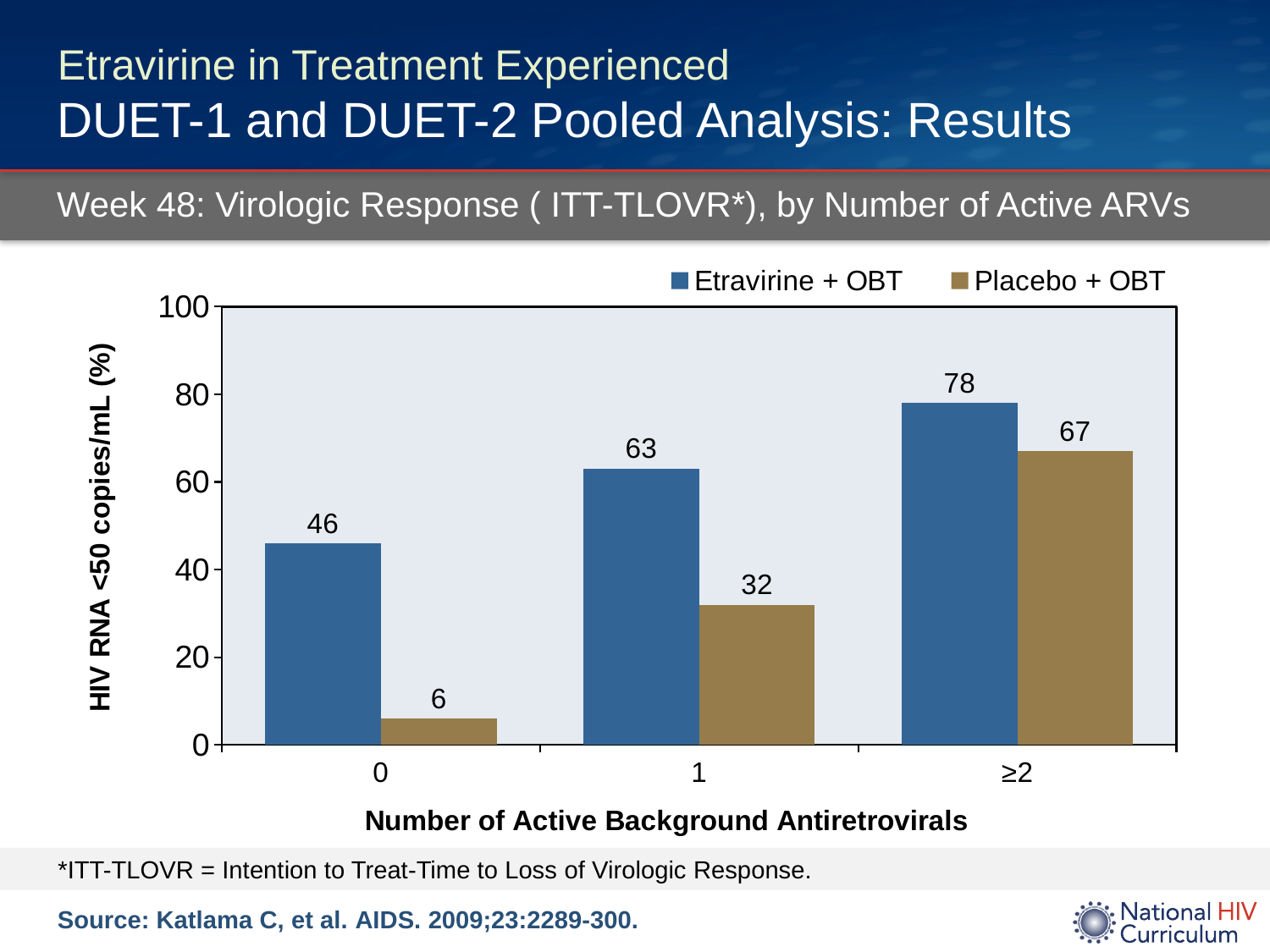
What is the difference between Etravirine + OBT and Placebo + OBT in the 0 active background antiretrovirals group? 40 What is the value for Placebo + OBT in the ≥2 active background antiretrovirals group? 67 What is the difference between Etravirine + OBT and Placebo + OBT in the 1 active background antiretroviral group? 31 What kind of chart is shown on the slide? Bar chart What is the value for Etravirine + OBT when the number of active background antiretrovirals is 0? 46 Which is larger in the ≥2 group: Etravirine + OBT or Placebo + OBT? Etravirine + OBT How many categories are shown on the x axis? 3 What is the value for Placebo + OBT when the number of active background antiretrovirals is 1? 32 How many series does the legend list? 2 Which category has the lowest value for Placebo + OBT? 0 Do the Placebo + OBT values rise or fall as the number of active background antiretrovirals increases? Rise Which category has the highest value for Etravirine + OBT? ≥2